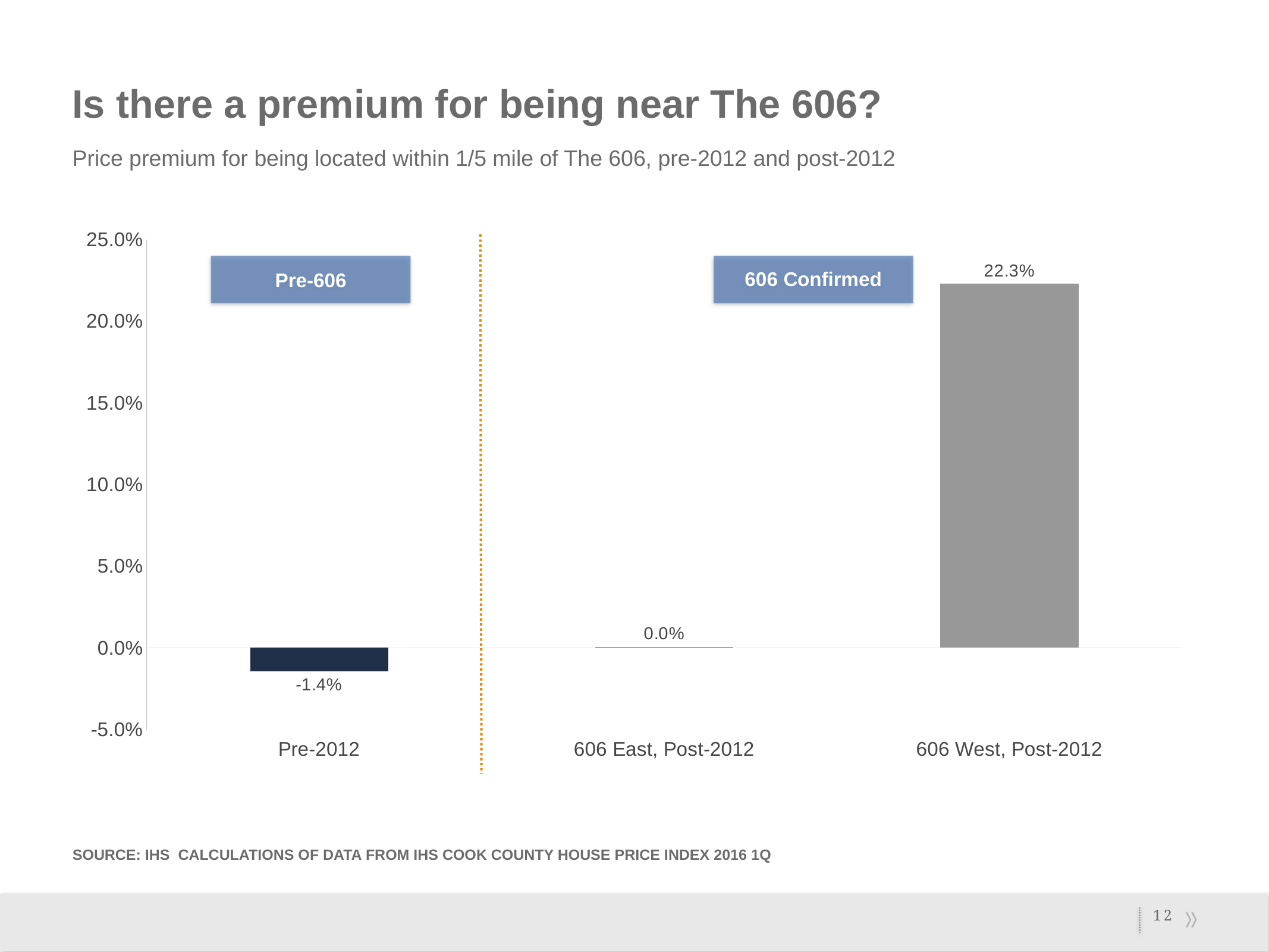
Which category has the lowest price premium? Pre-2012 What is the price premium value for 606 East, Post-2012? 0.0% What is the difference between the price premium for 606 West, Post-2012 and Pre-2012? 23.7% Is the value for 606 West, Post-2012 greater or less than 20.0%? greater What are the two labels shown in the blue boxes above the chart? Pre-606 and 606 Confirmed What is the difference between the price premium for 606 West, Post-2012 and 606 East, Post-2012? 22.3% Which category has the highest price premium? 606 West, Post-2012 What is the price premium value for Pre-2012? -1.4% How many categories are shown on the x axis of the chart? 3 What kind of chart is shown on the slide? bar chart Which is larger, the price premium for Pre-2012 or for 606 East, Post-2012? 606 East, Post-2012 What is the price premium value for 606 West, Post-2012? 22.3%